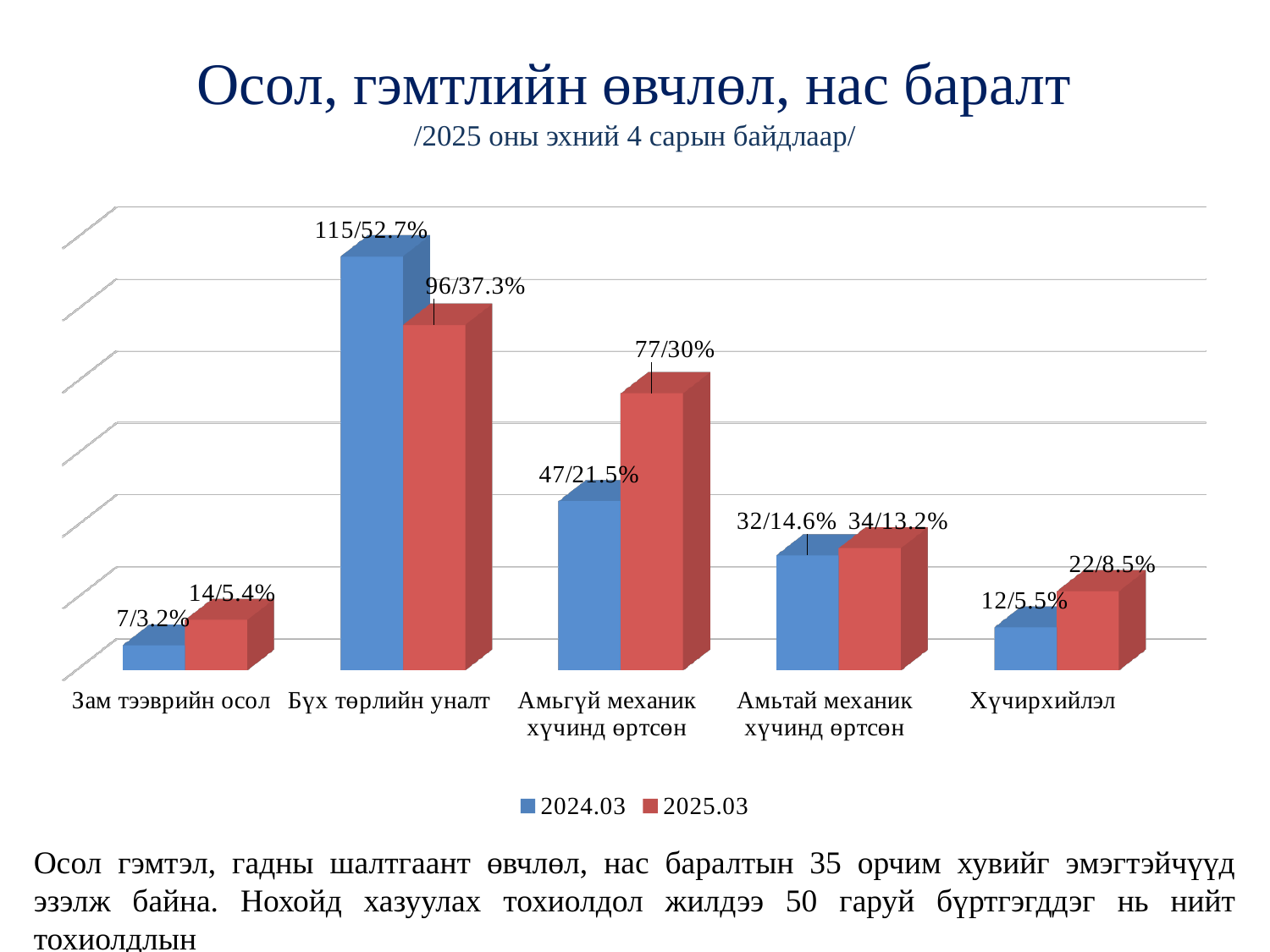
Which colour represents the 2025.03 series in the chart? Red Which category has the highest value in the 2025.03 series? Бүх төрлийн уналт What is the data label for Бүх төрлийн уналт in the 2024.03 series? 115/52.7% What is the data label for Амьгүй механик хүчинд өртсөн in the 2025.03 series? 77/30% How many categories are shown on the x axis of the chart? 5 What kind of chart is shown on the slide? Bar chart How many series does the legend list? 2 For Амьгүй механик хүчинд өртсөн, which series has the larger value, 2024.03 or 2025.03? 2025.03 What is the data label for Хүчирхийлэл in the 2024.03 series? 12/5.5% By how many cases does the 2024.03 count for Бүх төрлийн уналт exceed the 2025.03 count? 19 Which category has the lowest value in the 2024.03 series? Зам тээврийн осол What is the data label for Зам тээврийн осол in the 2025.03 series? 14/5.4%